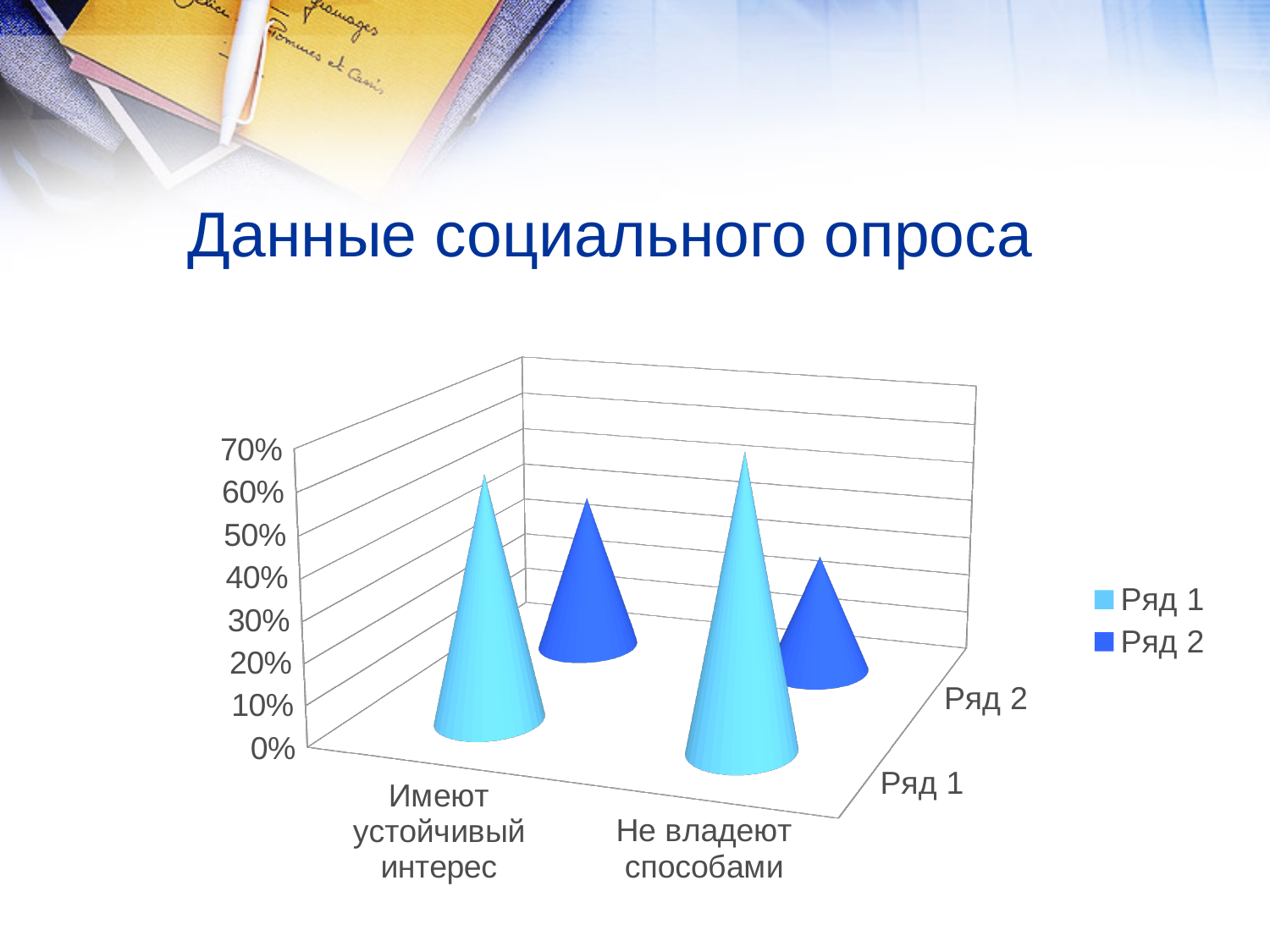
How many series does the legend list? 2 How many categories are shown on the x axis of the chart? 2 Is the value of Ряд 1 for 'Не владеют способами' greater or less than 50%? greater Which category has the lower value for Ряд 2? Не владеют способами For the category 'Не владеют способами', which series has the larger value, Ряд 1 or Ряд 2? Ряд 1 Is the value of Ряд 2 for 'Не владеют способами' greater or less than 50%? less What are the names of the series in the legend? Ряд 1, Ряд 2 Is the value of Ряд 1 for 'Имеют устойчивый интерес' greater or less than 40%? greater What is the title of the chart? Данные социального опроса Which category has the higher value for Ряд 1? Не владеют способами For the category 'Имеют устойчивый интерес', which series has the larger value, Ряд 1 or Ряд 2? Ряд 1 What kind of chart is shown on the slide? bar chart